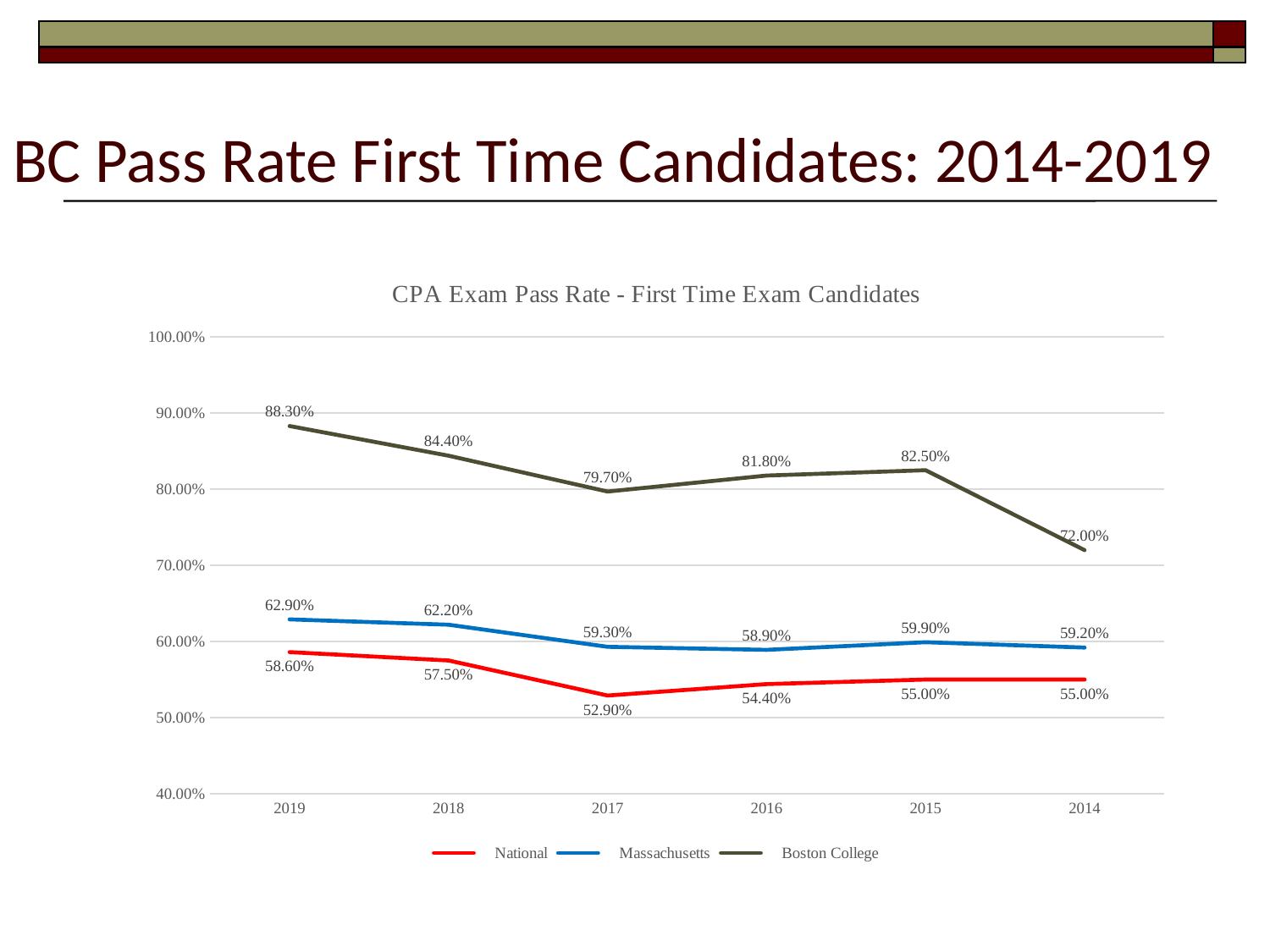
What kind of chart is shown on the slide? line chart In which year is the Massachusetts pass rate highest? 2019 What is the Boston College pass rate for 2019? 88.30% How many series does the legend list? 3 What is the Massachusetts pass rate for 2015? 59.90% In which year is the Boston College pass rate lowest? 2014 What is the difference between the Boston College and National pass rates in 2019? 29.70% What is the National pass rate for 2017? 52.90% How many years are shown on the x axis? 6 Is the Boston College pass rate for 2014 greater or less than 80.00%? less What is the title of the chart? CPA Exam Pass Rate - First Time Exam Candidates Which is higher in 2016, the Massachusetts pass rate or the National pass rate? Massachusetts